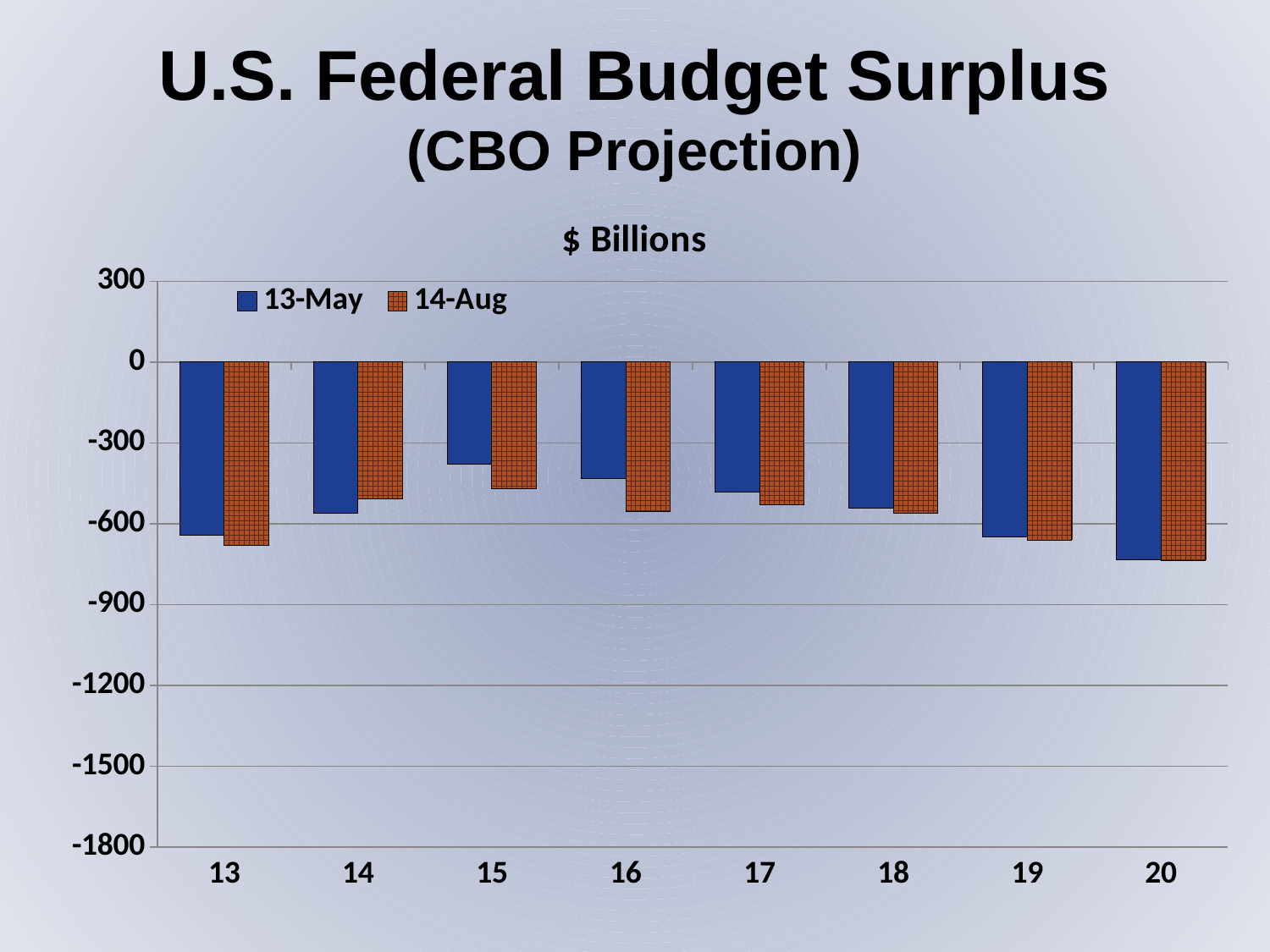
How many years are shown on the x axis? 8 Which year has the highest (least negative) 13-May value? 15 Is the 13-May value for 16 greater or less than -600? greater What kind of chart is shown on the slide? bar chart What are the two series named in the legend? 13-May and 14-Aug What unit label is shown above the chart? $ Billions Is the 13-May value for 15 greater or less than -300? less Is the 13-May value for 20 greater or less than -600? less Which year has the lowest (most negative) 13-May value? 20 How many series does the legend list? 2 For year 16, which series has the higher (less negative) value, 13-May or 14-Aug? 13-May